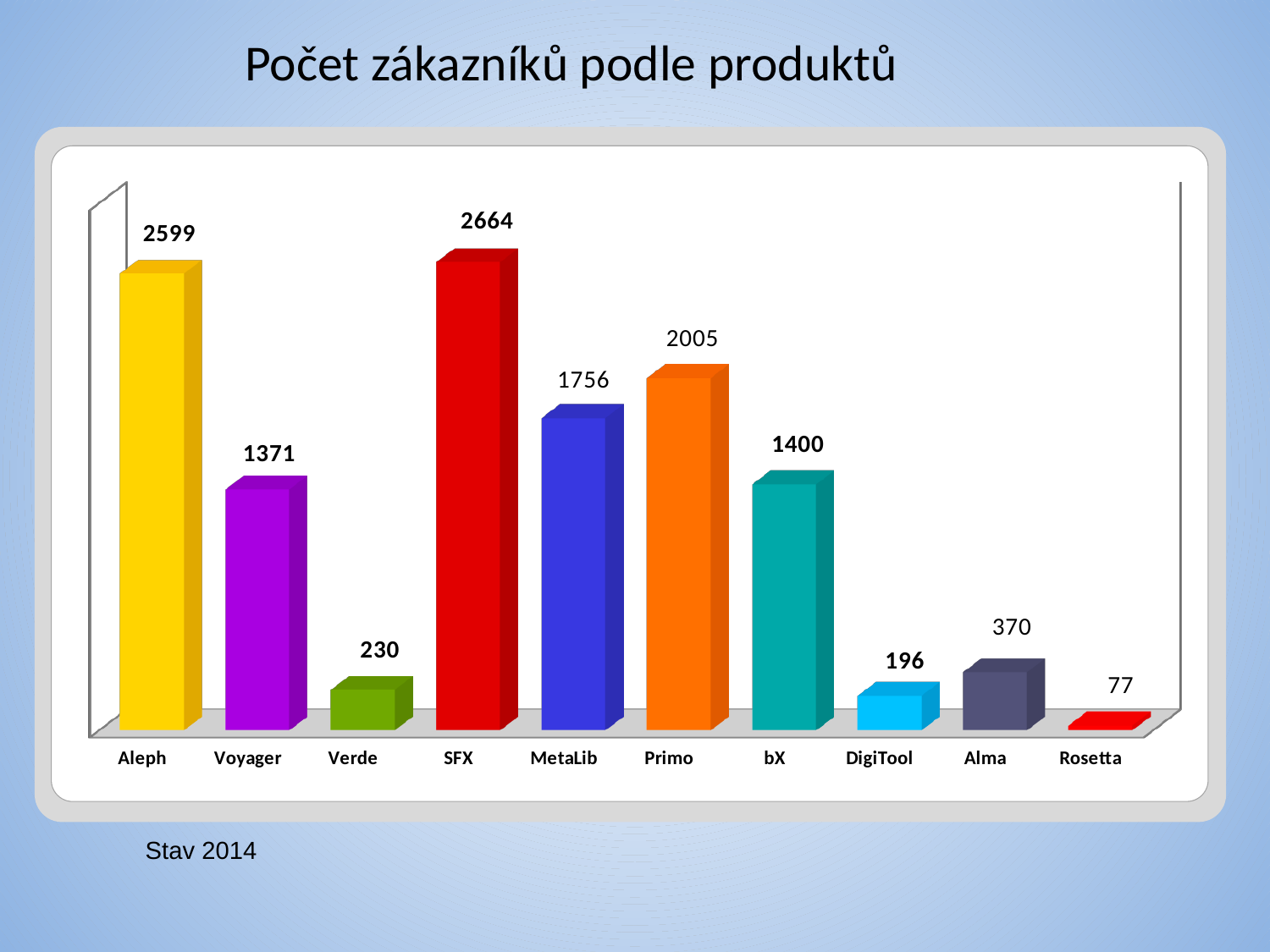
What is the value shown for DigiTool? 196 What is the title of the slide? Počet zákazníků podle produktů What is the value shown for Primo? 2005 Which has a larger value, Voyager or bX? bX Which product has the lowest number of customers? Rosetta What kind of chart is shown on the slide? Bar chart What is the number of customers for Aleph? 2599 Which has a larger value, Alma or Verde? Alma What is the difference between the values for SFX and Aleph? 65 Which product has the highest number of customers? SFX What is the difference between the values for Primo and MetaLib? 249 How many products are shown on the chart? 10